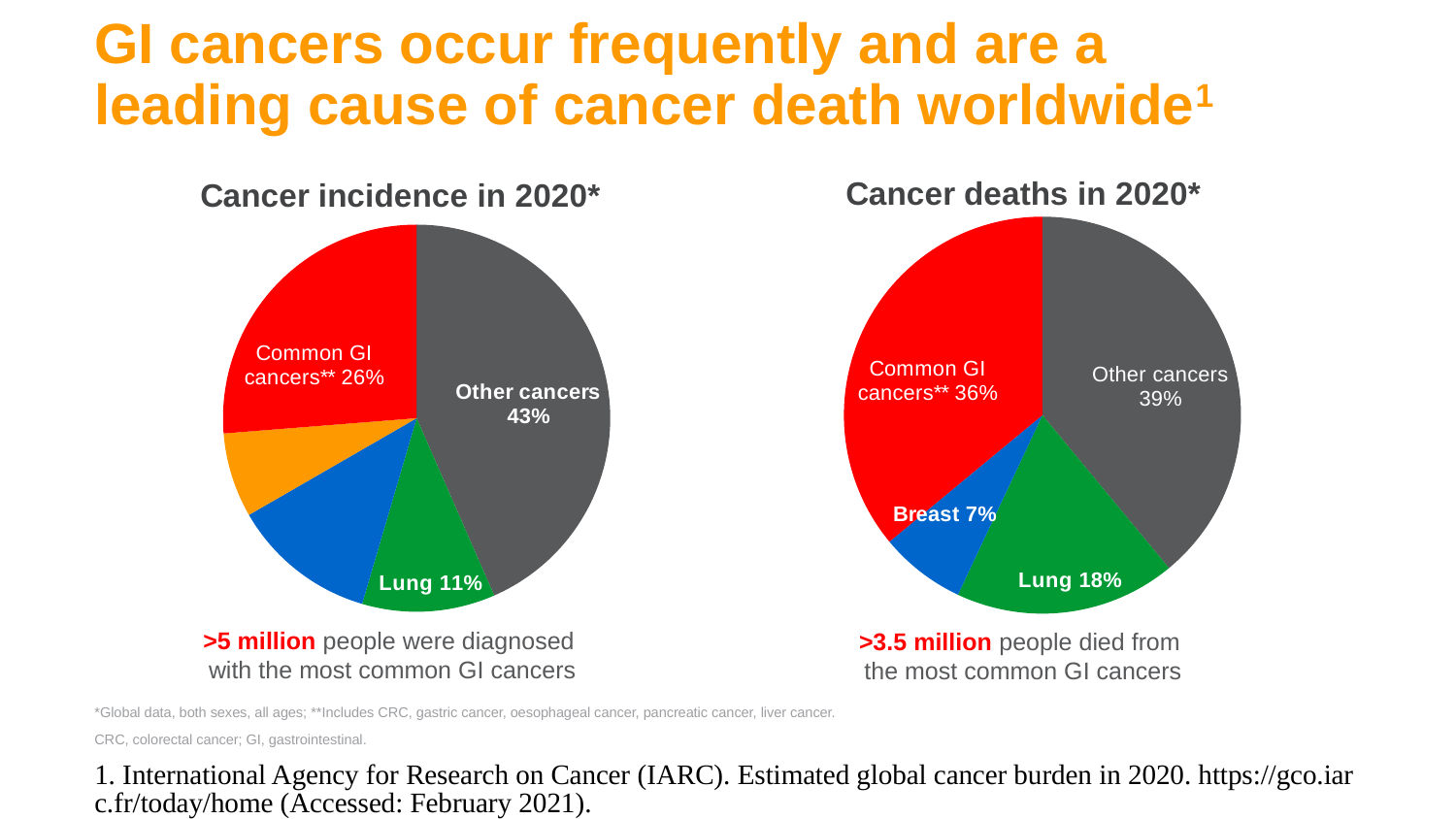
In the 'Cancer deaths in 2020*' chart, what share is labelled for Lung? 18% How many slices does the 'Cancer deaths in 2020*' pie chart have? 4 In the 'Cancer incidence in 2020*' chart, which slice is the largest? Other cancers In the 'Cancer incidence in 2020*' chart, what share is labelled for Common GI cancers? 26% Is the Lung share larger in the 'Cancer incidence in 2020*' chart or in the 'Cancer deaths in 2020*' chart? Cancer deaths in 2020* In the 'Cancer incidence in 2020*' chart, what share is labelled for Other cancers? 43% In the 'Cancer incidence in 2020*' chart, what is the difference between the Other cancers share and the Common GI cancers share? 17% In the 'Cancer deaths in 2020*' chart, what share is labelled for Breast? 7% In the 'Cancer deaths in 2020*' chart, what share is labelled for Common GI cancers? 36% What type of chart is used for 'Cancer incidence in 2020*'? Pie chart In the 'Cancer deaths in 2020*' chart, which labelled slice is the smallest? Breast In the 'Cancer deaths in 2020*' chart, what is the difference between the Lung share and the Breast share? 11%